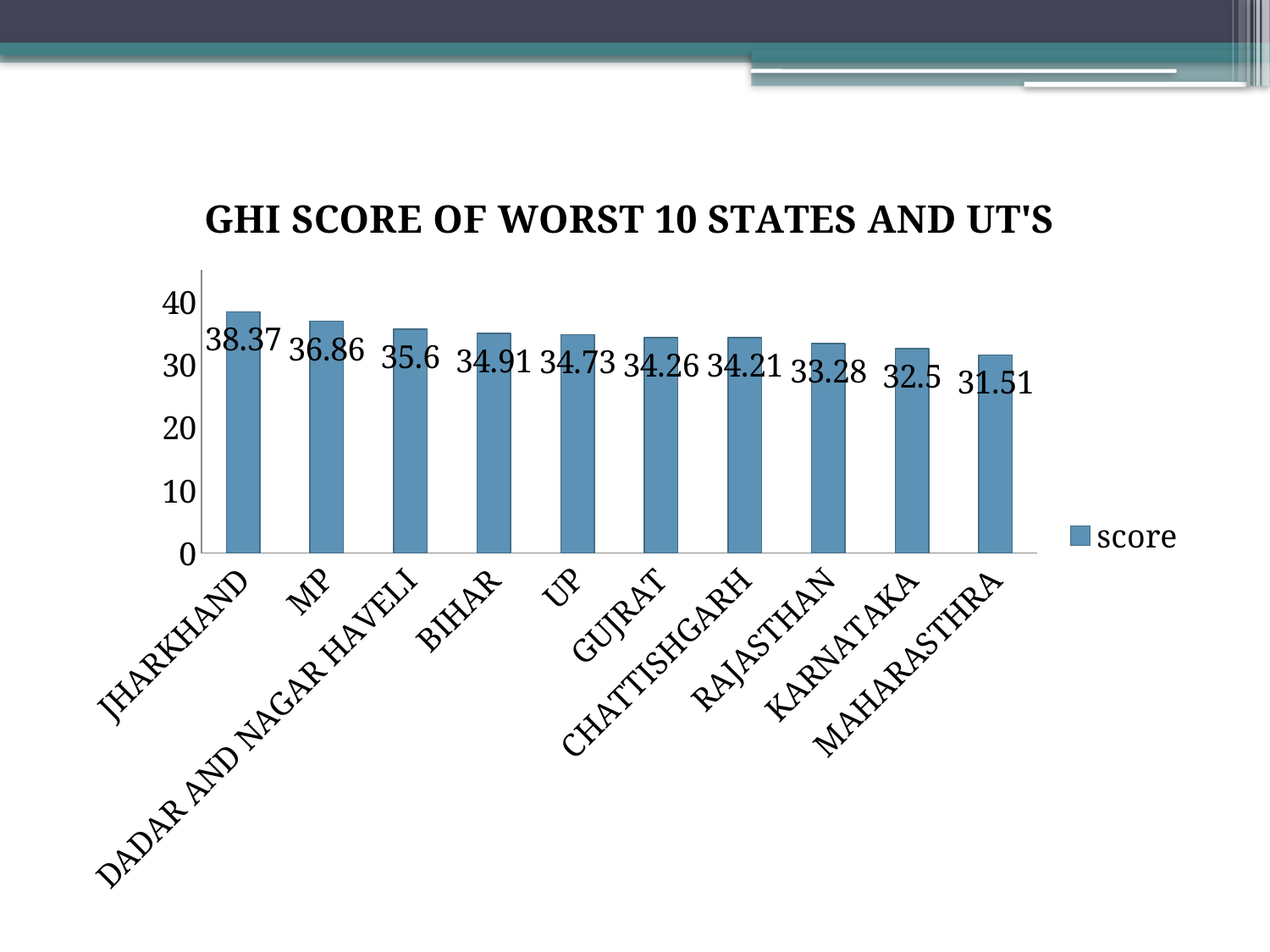
Do the GHI scores rise or fall from left to right along the x axis? fall What is the GHI score for BIHAR? 34.91 Which state or UT has the lowest GHI score? MAHARASTHRA What is the GHI score for KARNATAKA? 32.5 What is the difference between the GHI scores of JHARKHAND and MP? 1.51 What kind of chart is shown on the slide? bar chart Which has a higher GHI score, UP or RAJASTHAN? UP What is the GHI score for JHARKHAND? 38.37 How many series does the legend list? 1 Which state or UT has the highest GHI score? JHARKHAND How many states and UTs are shown in the chart? 10 What is the difference between the GHI scores of DADAR AND NAGAR HAVELI and MAHARASTHRA? 4.09